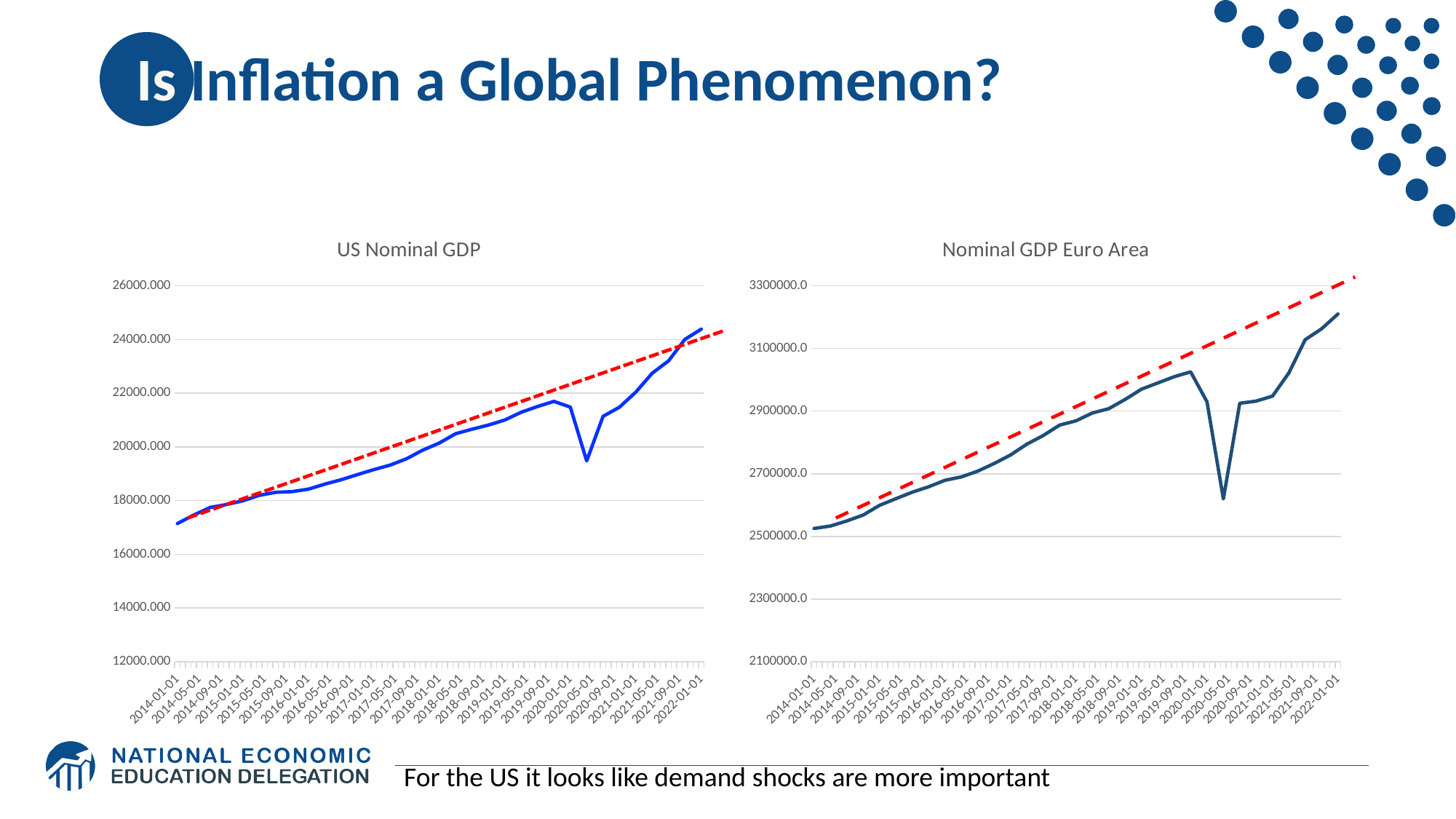
In the US Nominal GDP chart, at which date is the plotted value lowest? 2014-01-01 What kind of chart is the US Nominal GDP chart? line chart In the Nominal GDP Euro Area chart, do the values generally rise or fall from 2014-01-01 to 2022-01-01? rise In the US Nominal GDP chart, what colour is the dashed trend line? red In the Nominal GDP Euro Area chart, at which date is the plotted value highest? 2022-01-01 In the US Nominal GDP chart, is the value at 2022-01-01 greater or less than 22000.000? greater What kind of chart is the Nominal GDP Euro Area chart? line chart What is the title of the chart on the right side of the slide? Nominal GDP Euro Area In the US Nominal GDP chart, do the values generally rise or fall from 2014-01-01 to 2022-01-01? rise In the US Nominal GDP chart, is the value at 2014-01-01 greater or less than 18000.000? less In the Nominal GDP Euro Area chart, is the value at 2022-01-01 greater or less than 3100000.0? greater